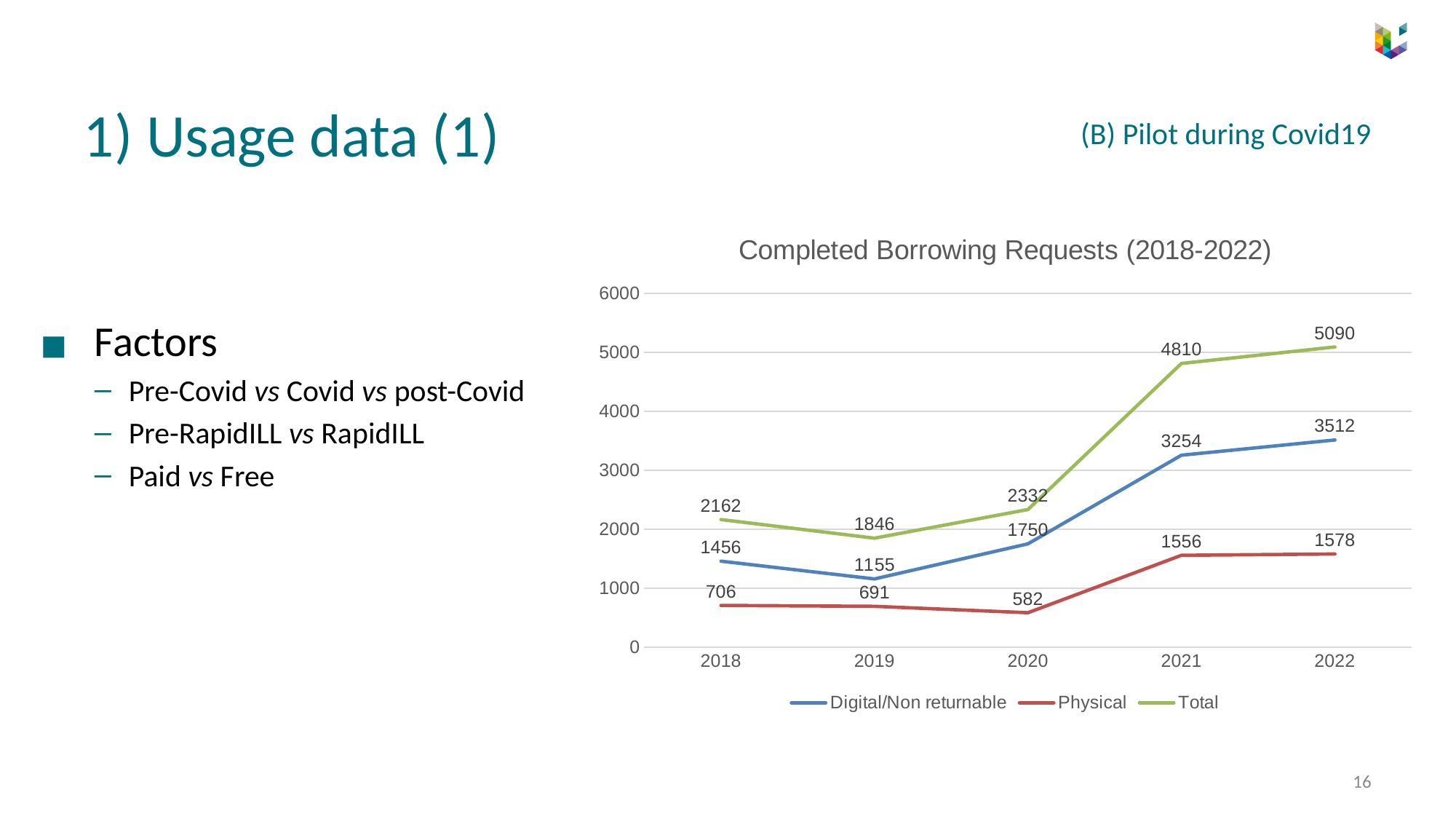
What is the title of the chart? Completed Borrowing Requests (2018-2022) Is the Total value for 2021 greater or less than 4000? greater What is the value for Digital/Non returnable in 2021? 3254 Which is larger: Digital/Non returnable in 2019 or Physical in 2019? Digital/Non returnable in 2019 What is the value for Physical in 2020? 582 How many series does the legend list? 3 In which year is the Physical series lowest? 2020 In which year is the Total highest? 2022 How many years are shown on the x axis? 5 What is the difference between the Total in 2022 and the Total in 2021? 280 What is the Total value in 2018? 2162 What kind of chart is shown on the slide? line chart